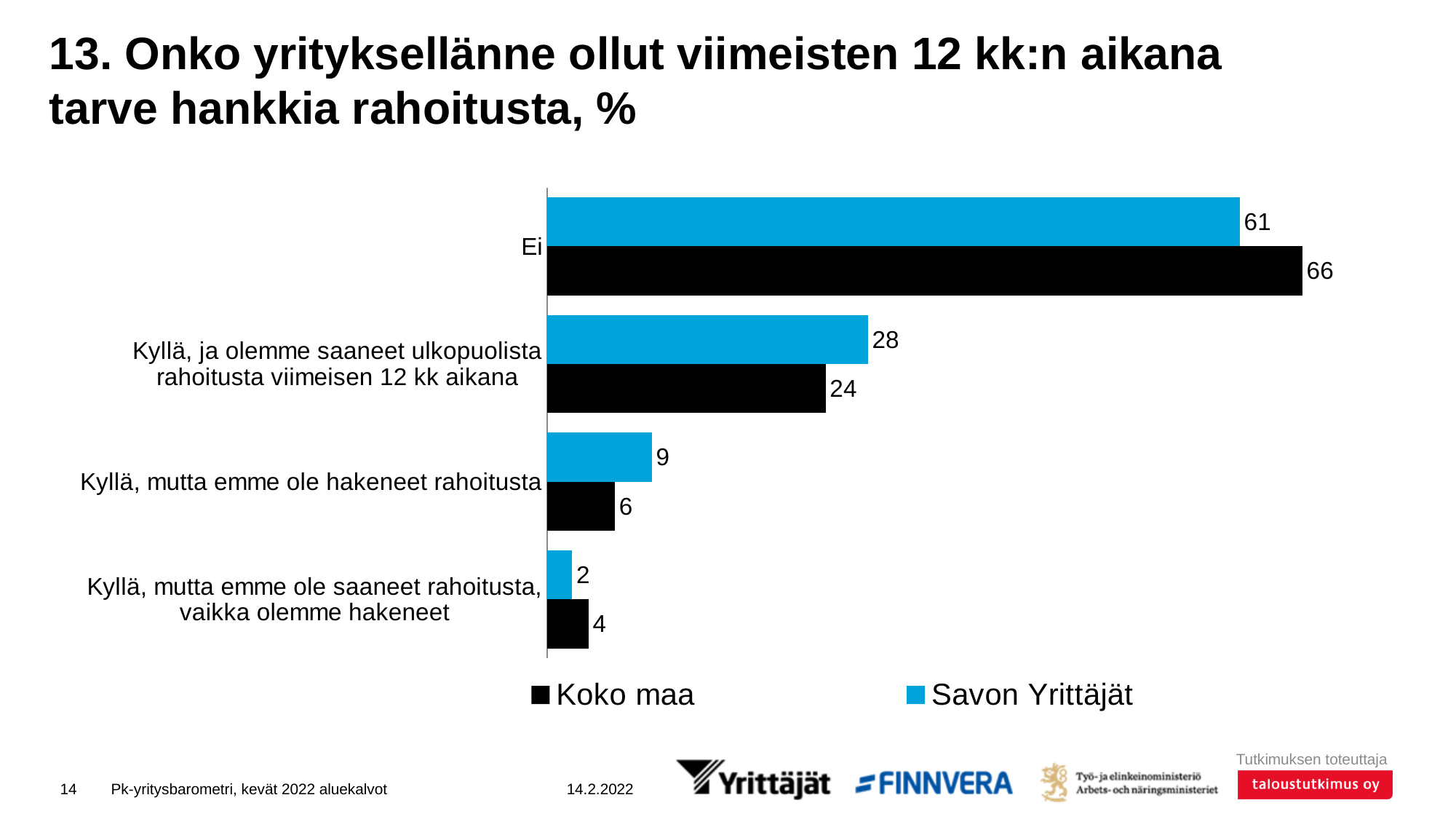
How many categories are shown on the chart? 4 What is the value for Savon Yrittäjät in the 'Ei' category? 61 What is the difference between Savon Yrittäjät and Koko maa in the category 'Kyllä, ja olemme saaneet ulkopuolista rahoitusta viimeisen 12 kk aikana'? 4 Which category has the lowest value for Savon Yrittäjät? Kyllä, mutta emme ole saaneet rahoitusta, vaikka olemme hakeneet What is the difference between Koko maa and Savon Yrittäjät in the 'Ei' category? 5 What kind of chart is shown on the slide? Bar chart What is the value for Koko maa in the category 'Kyllä, mutta emme ole hakeneet rahoitusta'? 6 In the category 'Kyllä, mutta emme ole saaneet rahoitusta, vaikka olemme hakeneet', which series has the larger value, Koko maa or Savon Yrittäjät? Koko maa What is the value for Savon Yrittäjät in the category 'Kyllä, ja olemme saaneet ulkopuolista rahoitusta viimeisen 12 kk aikana'? 28 Which category has the highest value for Koko maa? Ei How many series does the legend list? 2 What is the value for Koko maa in the 'Ei' category? 66